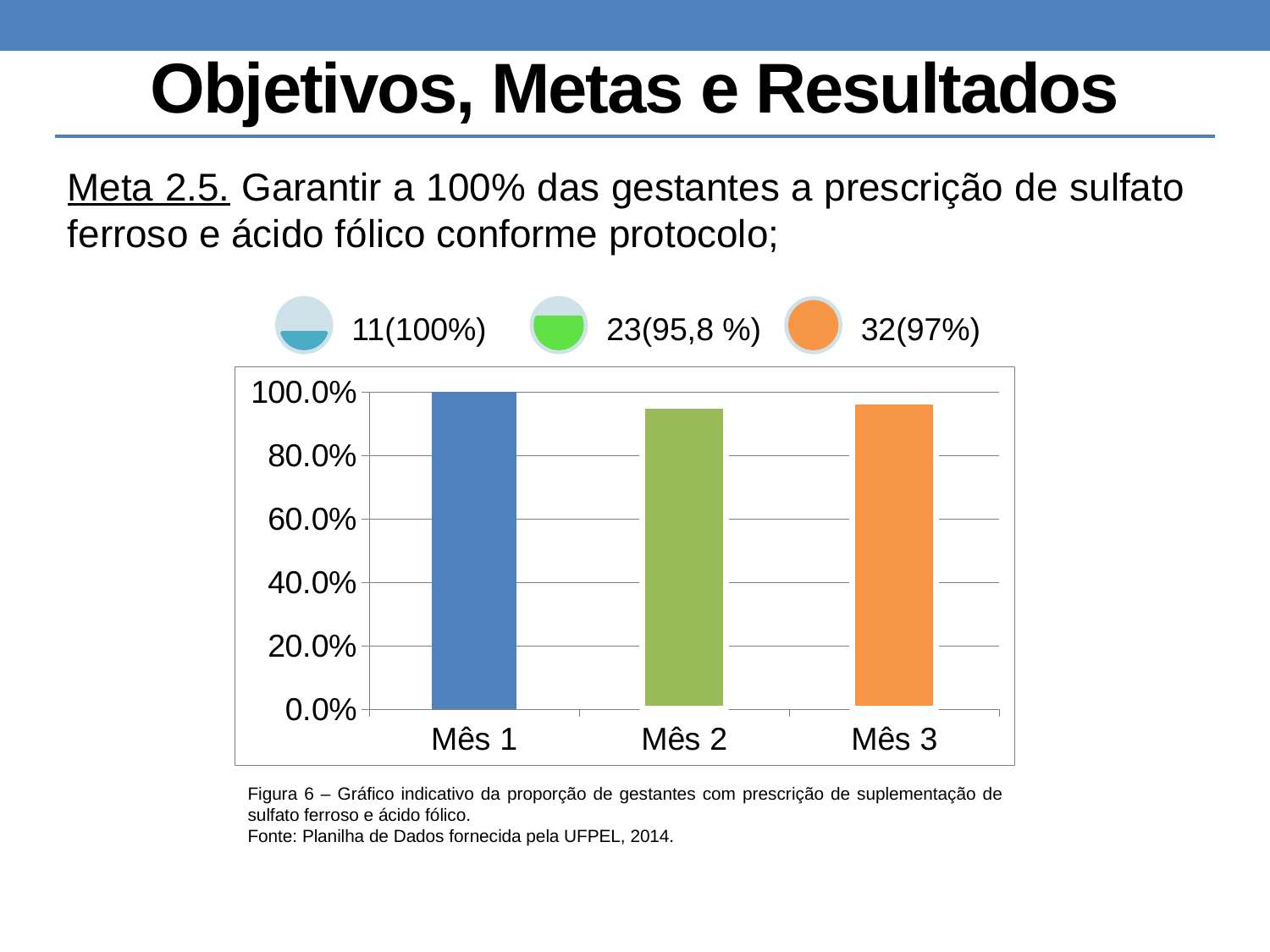
What is the value for Mês 1 in the chart? 100% Does the value fall or rise from Mês 1 to Mês 2? fall Which month has the lowest value in the chart? Mês 2 How many months (categories) are shown on the x axis of the chart? 3 What is the figure number given in the caption below the chart? Figura 6 What type of chart is shown on the slide? bar chart According to the labels above the chart, what percentage corresponds to Mês 3? 97% What colour is the bar for Mês 3? orange Which month has the highest value in the chart? Mês 1 Which is larger, the value for Mês 2 or the value for Mês 3? Mês 3 According to the labels above the chart, what percentage corresponds to Mês 2? 95,8 % Is the value for Mês 2 greater or less than 80.0%? greater